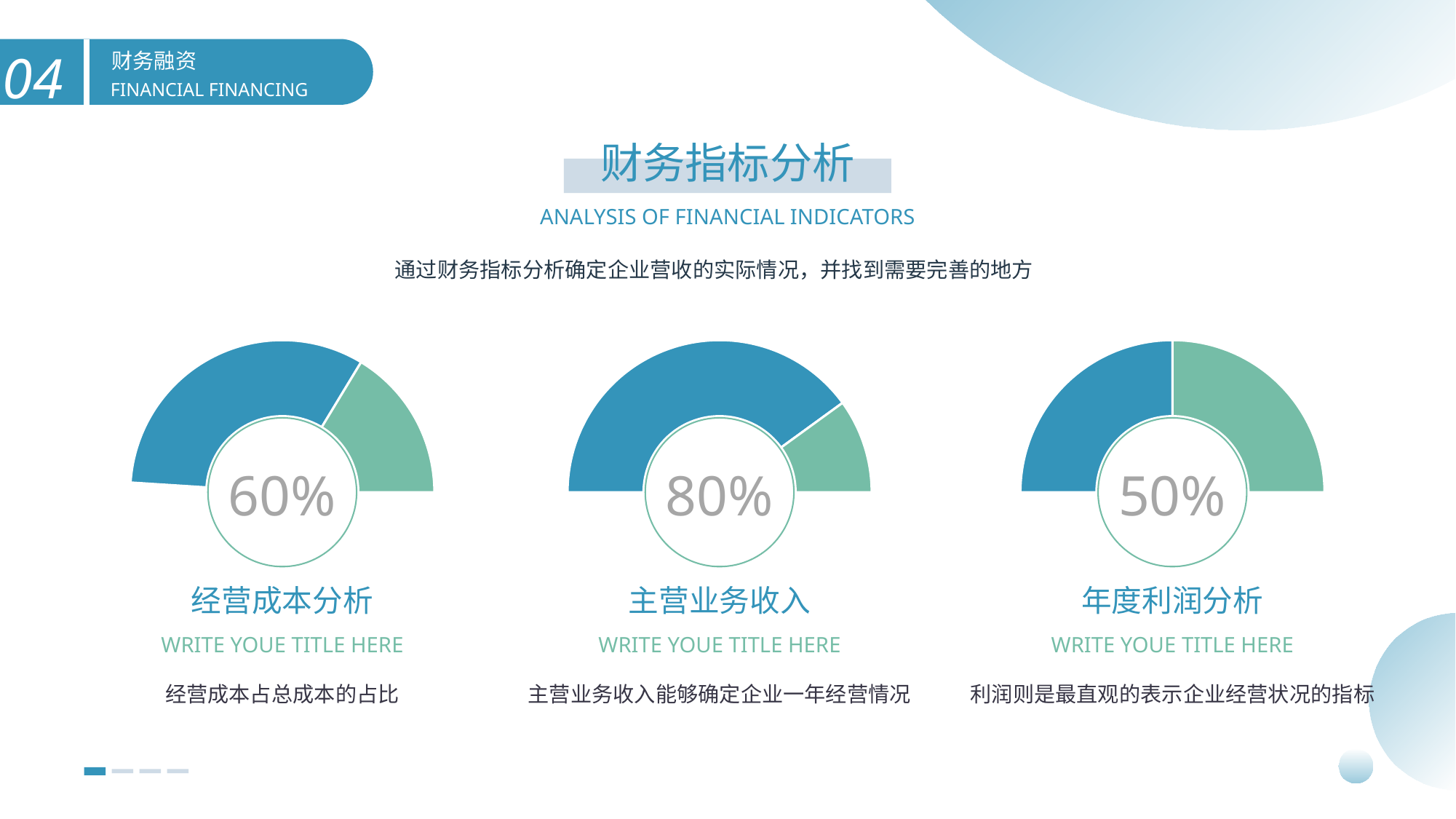
Which of the three charts shows the highest percentage? 主营业务收入 What is the difference between the percentage in the 经营成本分析 chart and the percentage in the 年度利润分析 chart? 10% What is the difference between the percentage in the 主营业务收入 chart and the percentage in the 经营成本分析 chart? 20% Is the percentage in the 主营业务收入 chart greater or less than 50%? greater What colour is the filled portion of the gauge in the 经营成本分析 chart? Blue What percentage is shown in the 经营成本分析 chart? 60% Which of the three charts shows the lowest percentage? 年度利润分析 Which is larger, the percentage in the 经营成本分析 chart or the percentage in the 年度利润分析 chart? 经营成本分析 What kind of chart is used for the 年度利润分析 figure? Semicircular gauge (donut) chart What percentage is shown in the 年度利润分析 chart? 50% How many gauge charts are shown on the slide? 3 What percentage is shown in the 主营业务收入 chart? 80%